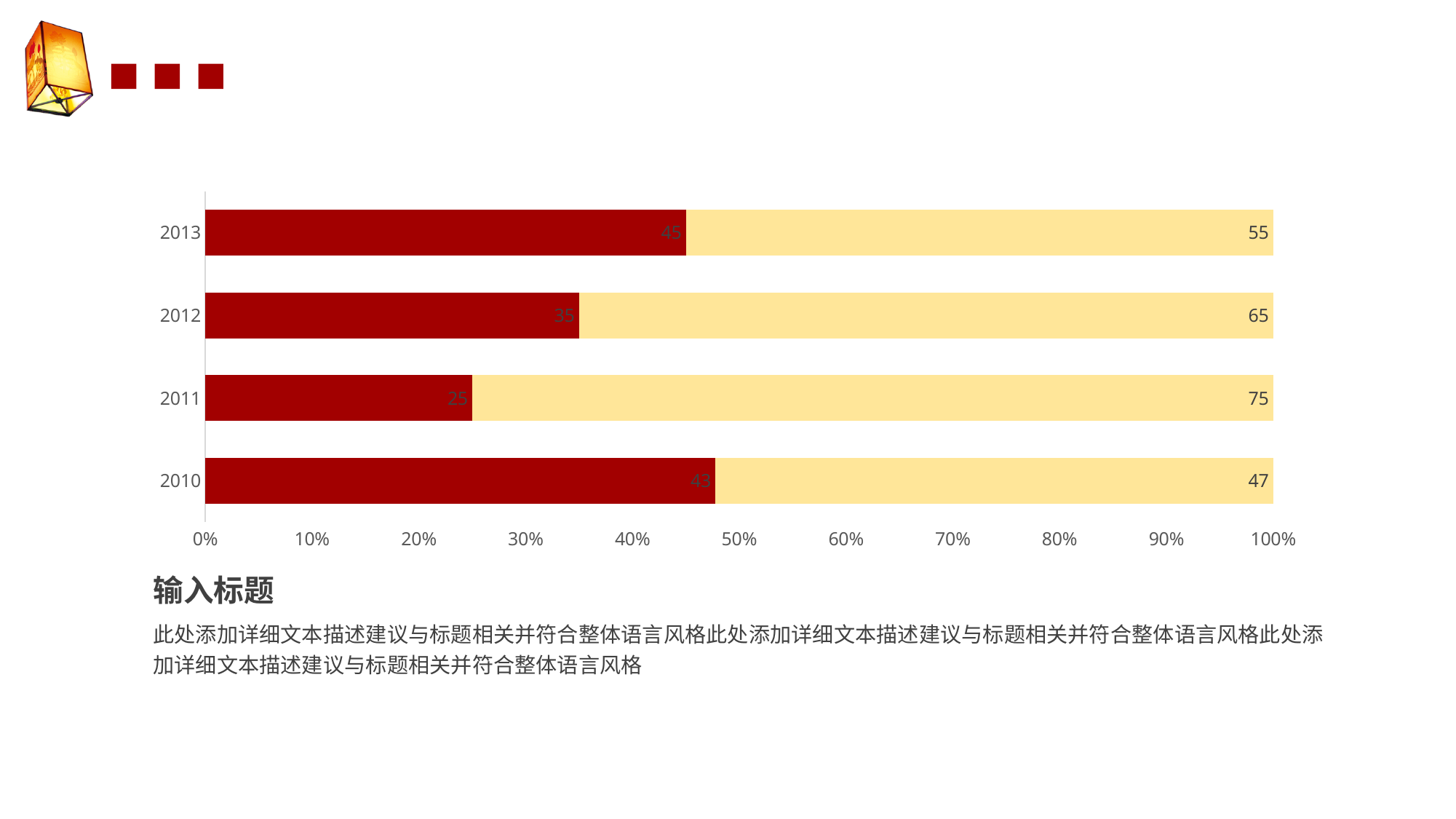
Which year has the highest value for the yellow segment? 2011 What is the difference between the yellow segment values for 2011 and 2012? 10 How many years are shown on the chart? 4 What is the value of the yellow segment for 2012? 65 Which year has the lowest value for the red segment? 2011 What is the value of the yellow segment for 2011? 75 What is the value of the red segment for 2013? 45 Which year has the highest value for the red segment? 2013 What kind of chart is shown on the slide? Stacked bar chart Which is larger, the red segment for 2012 or the red segment for 2010? 2010 What is the value of the red segment for 2010? 43 What is the total of the two labelled segments for 2013? 100